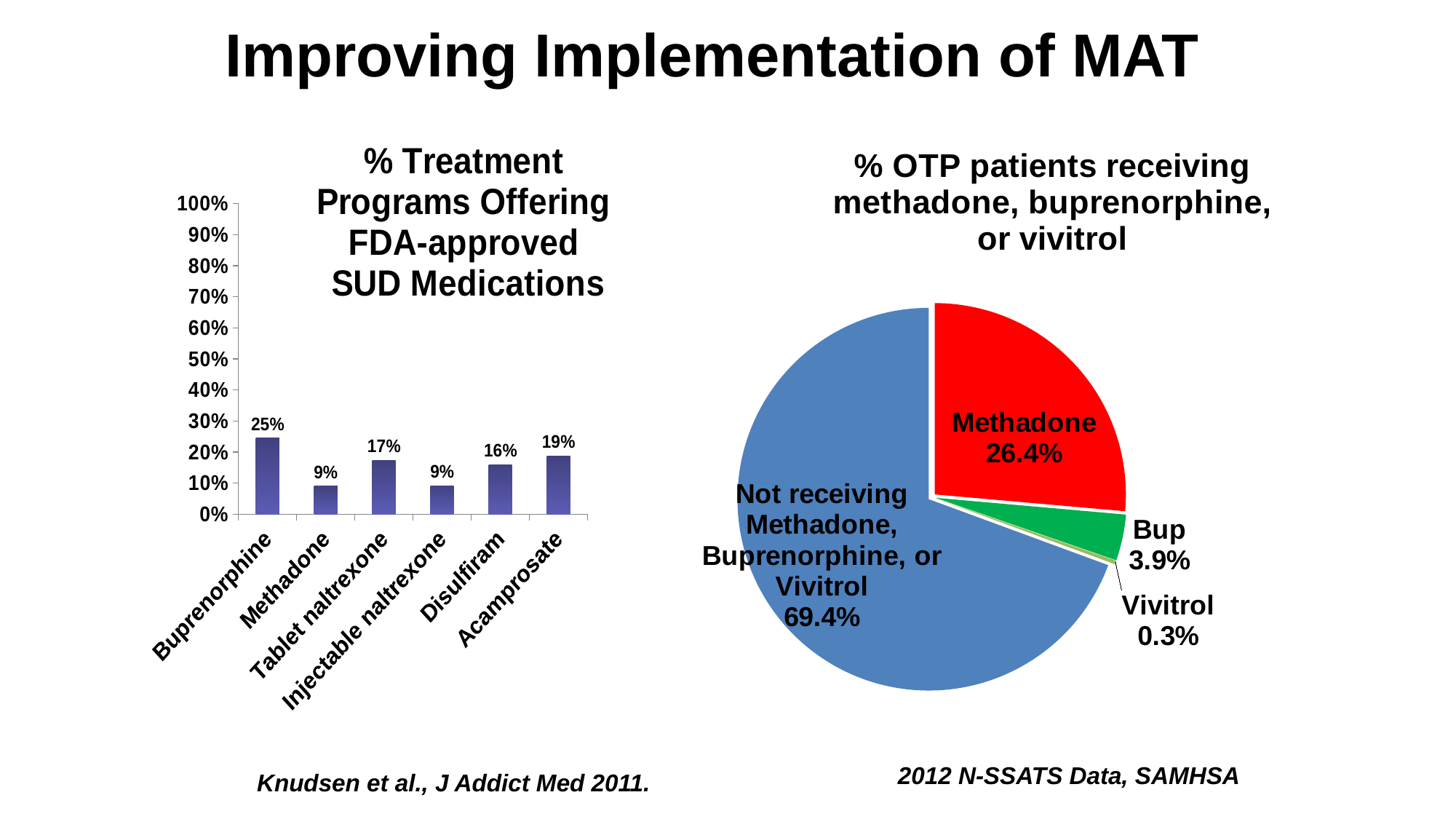
In the pie chart '% OTP patients receiving methadone, buprenorphine, or vivitrol', what share of patients receive Methadone? 26.4% In the bar chart '% Treatment Programs Offering FDA-approved SUD Medications', what is the difference between the values for Buprenorphine and Disulfiram? 9% In the bar chart '% Treatment Programs Offering FDA-approved SUD Medications', which medication has the highest percentage? Buprenorphine In the bar chart '% Treatment Programs Offering FDA-approved SUD Medications', what percentage of programs offer Buprenorphine? 25% In the pie chart '% OTP patients receiving methadone, buprenorphine, or vivitrol', which slice is the smallest? Vivitrol In the bar chart '% Treatment Programs Offering FDA-approved SUD Medications', how many medications are shown on the x axis? 6 In the pie chart '% OTP patients receiving methadone, buprenorphine, or vivitrol', what is the difference between the Methadone and Bup shares? 22.5% In the bar chart '% Treatment Programs Offering FDA-approved SUD Medications', which is larger, Tablet naltrexone or Injectable naltrexone? Tablet naltrexone In the bar chart '% Treatment Programs Offering FDA-approved SUD Medications', is the value for Methadone greater or less than 20%? less What kind of chart is the right chart, '% OTP patients receiving methadone, buprenorphine, or vivitrol'? Pie chart What kind of chart is the left chart, '% Treatment Programs Offering FDA-approved SUD Medications'? Bar chart In the bar chart '% Treatment Programs Offering FDA-approved SUD Medications', what is the value for Acamprosate? 19%